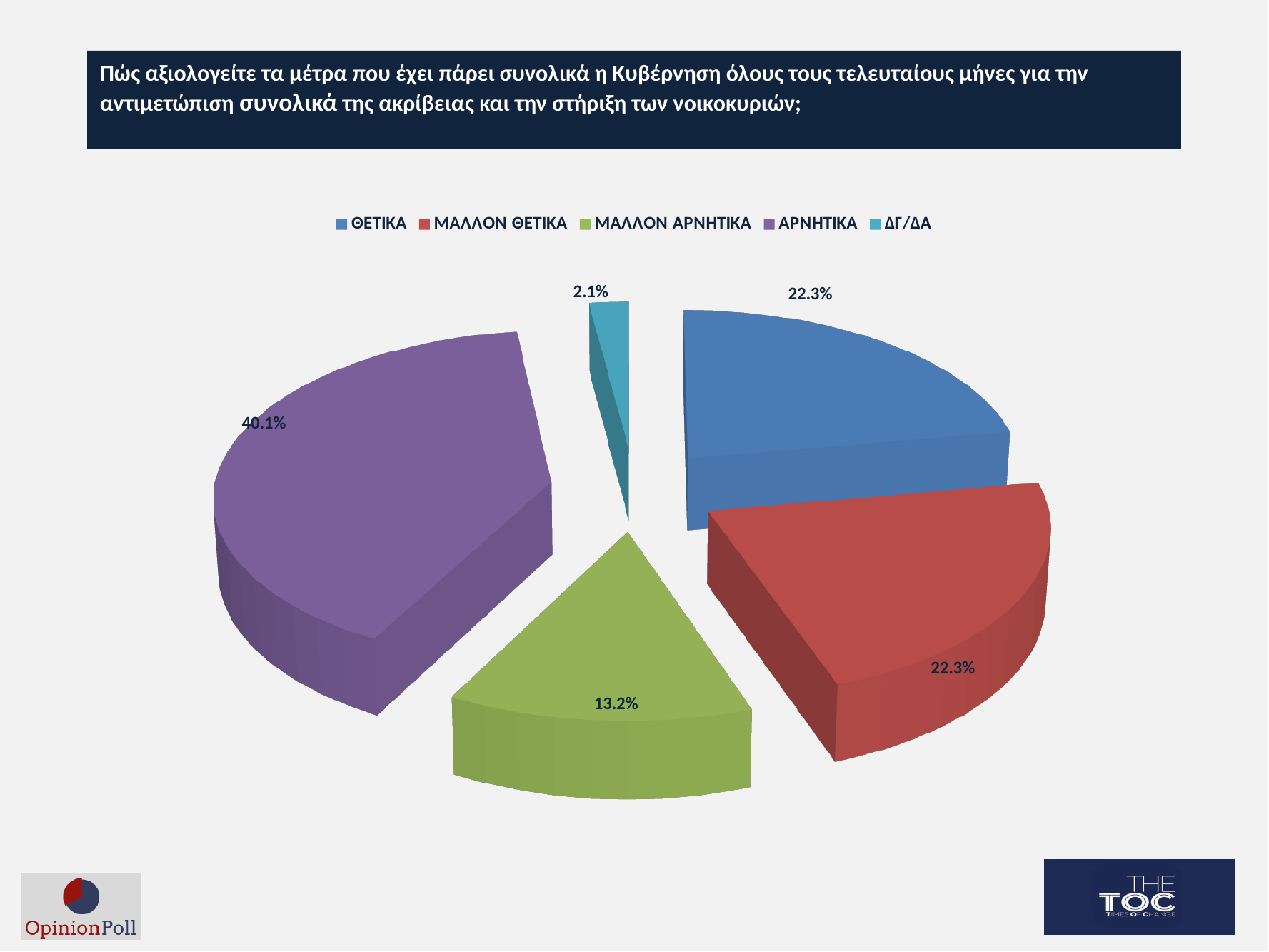
What kind of chart is shown on the slide? pie chart What percentage of respondents answered ΔΓ/ΔΑ? 2.1% Which category has the largest share of the pie? ΑΡΝΗΤΙΚΑ What is the combined share of ΘΕΤΙΚΑ and ΜΑΛΛΟΝ ΘΕΤΙΚΑ? 44.6% Which category has the smallest share of the pie? ΔΓ/ΔΑ What colour is the ΑΡΝΗΤΙΚΑ slice? purple How many categories does the legend list? 5 What percentage of respondents answered ΜΑΛΛΟΝ ΑΡΝΗΤΙΚΑ? 13.2% What is the difference in percentage points between ΑΡΝΗΤΙΚΑ and ΜΑΛΛΟΝ ΑΡΝΗΤΙΚΑ? 26.9 Which is larger, the share for ΜΑΛΛΟΝ ΘΕΤΙΚΑ or the share for ΜΑΛΛΟΝ ΑΡΝΗΤΙΚΑ? ΜΑΛΛΟΝ ΘΕΤΙΚΑ What percentage of respondents answered ΘΕΤΙΚΑ? 22.3% What percentage of respondents answered ΑΡΝΗΤΙΚΑ? 40.1%